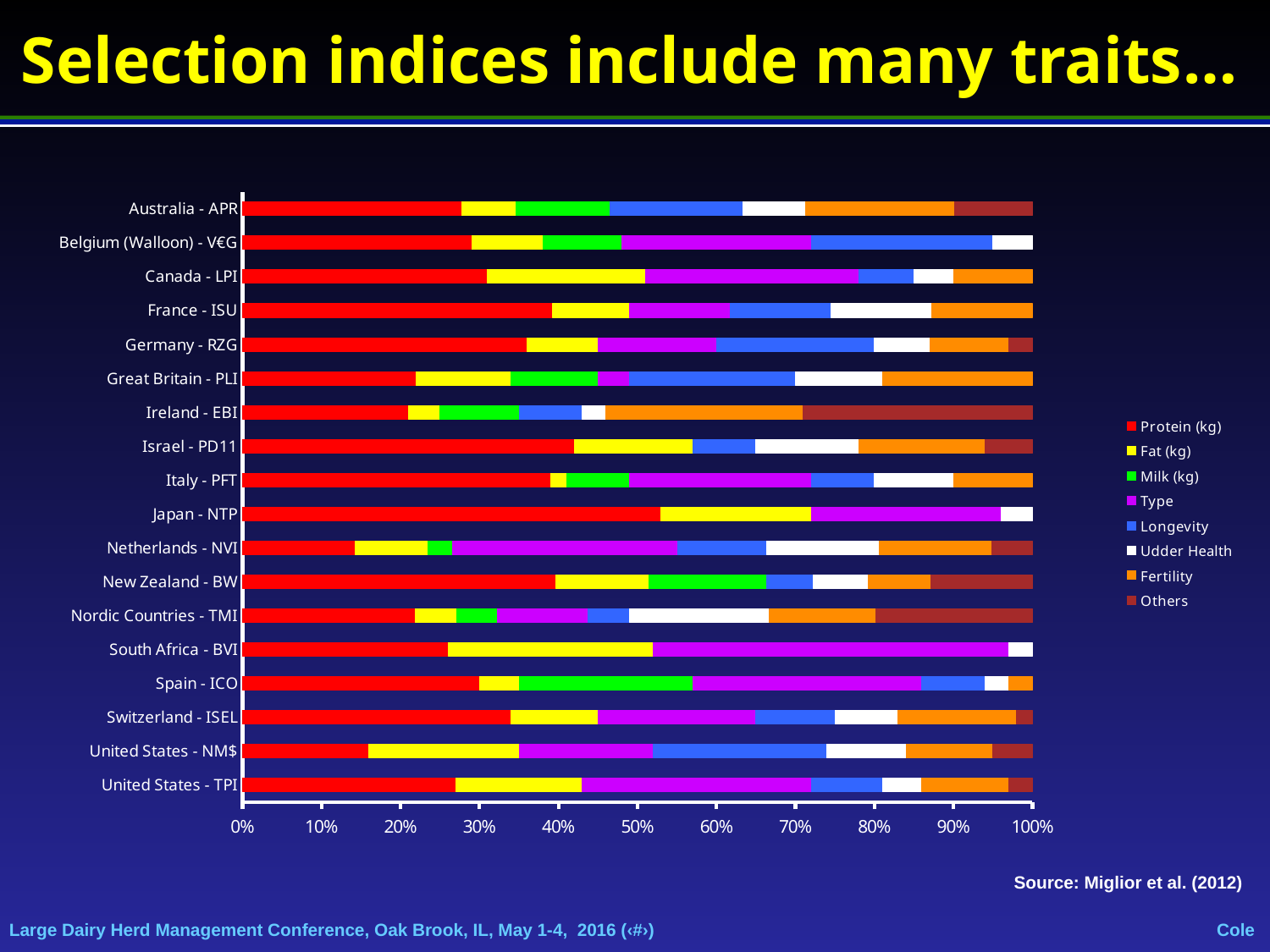
Which selection index has the largest Fertility share? Ireland - EBI How many series does the legend list? 8 What kind of chart is shown on the slide? Stacked bar chart Which selection index has the largest Type share? South Africa - BVI Which has a larger Protein (kg) share, Japan - NTP or United States - NM$? Japan - NTP Which has a larger Fat (kg) share, Canada - LPI or Australia - APR? Canada - LPI What is the first series listed in the legend? Protein (kg) Which selection index has the largest Others share? Ireland - EBI Is the Protein (kg) share for Japan - NTP greater or less than 40%? greater Is the Protein (kg) share for Netherlands - NVI greater or less than 20%? less How many selection indices (categories) are plotted on the chart? 18